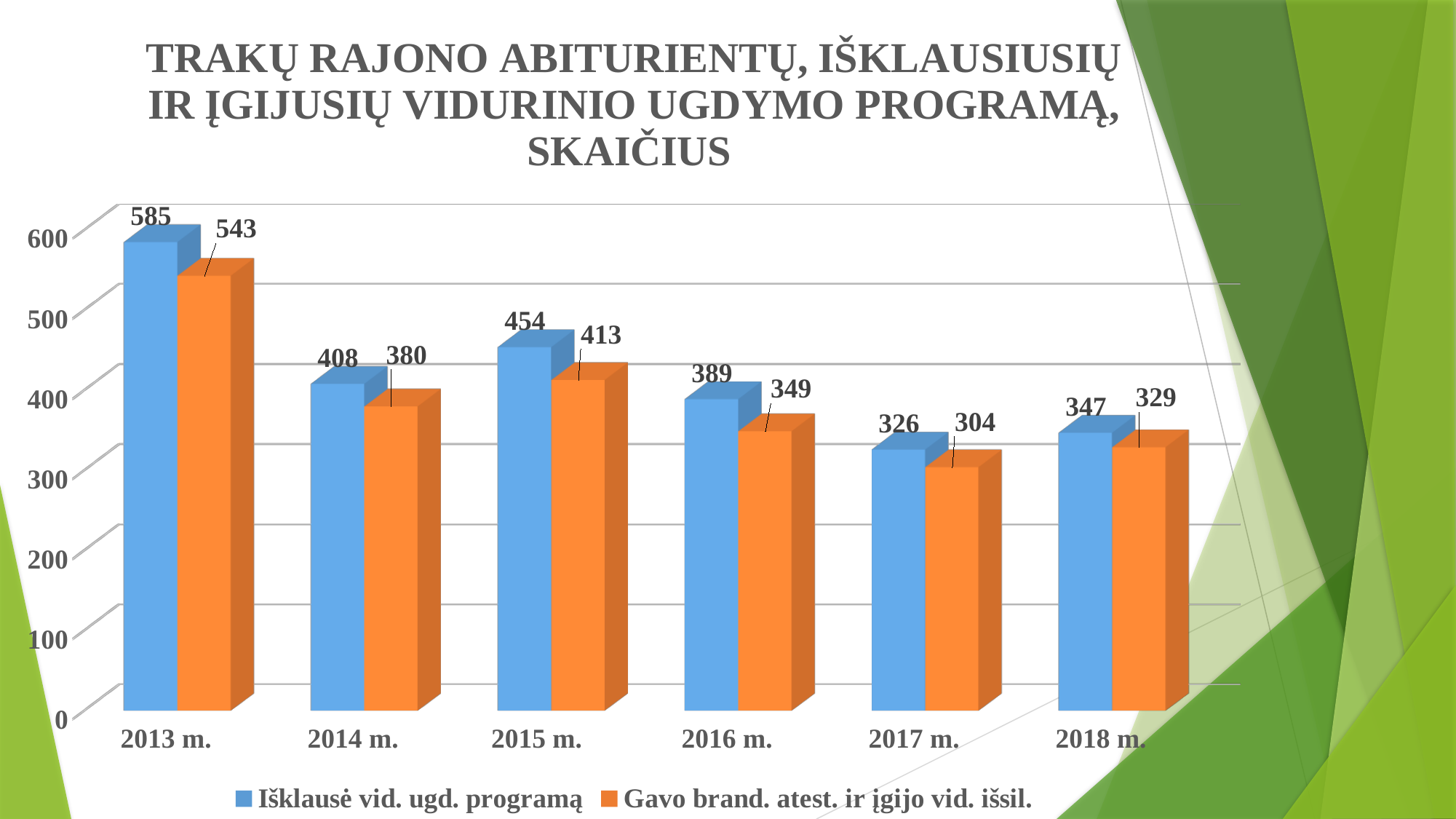
What is the value for "Išklausė vid. ugd. programą" in 2013 m.? 585 What is the value for "Gavo brand. atest. ir įgijo vid. išsil." in 2016 m.? 349 How many series does the legend list? 2 Which colour represents "Gavo brand. atest. ir įgijo vid. išsil." in the chart? Orange What kind of chart is shown on the slide? Bar chart Which year has the lowest value for "Gavo brand. atest. ir įgijo vid. išsil."? 2017 m. What is the difference between the two series in 2014 m.? 28 How many years are shown on the x axis? 6 Which year has the highest value for "Išklausė vid. ugd. programą"? 2013 m. What is the value for "Išklausė vid. ugd. programą" in 2018 m.? 347 Which is larger: "Išklausė vid. ugd. programą" in 2016 m. or "Gavo brand. atest. ir įgijo vid. išsil." in 2015 m.? Gavo brand. atest. ir įgijo vid. išsil. in 2015 m. What is the difference between the "Išklausė vid. ugd. programą" values for 2013 m. and 2015 m.? 131